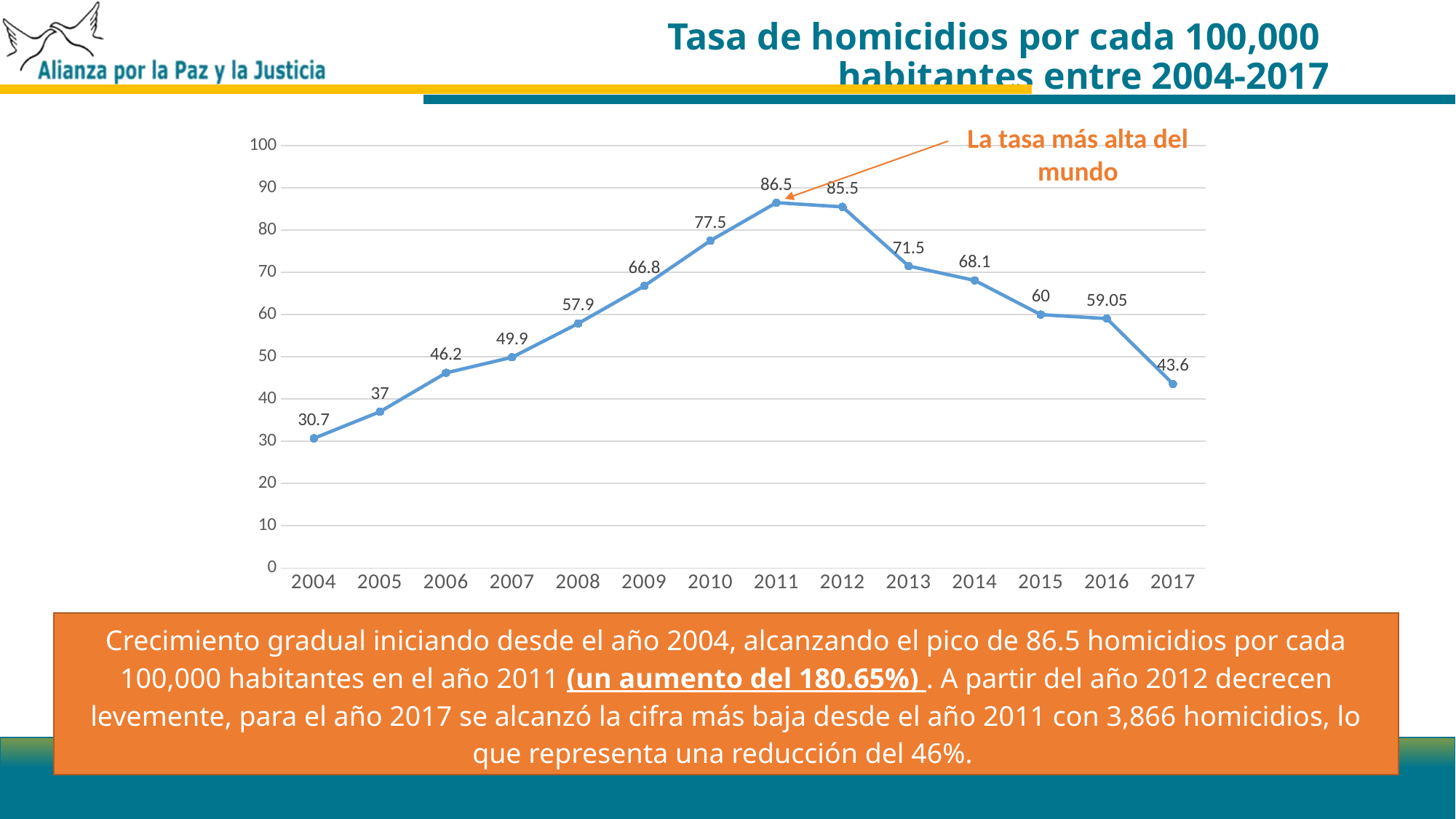
What is the homicide rate shown for 2011? 86.5 Which year has a higher homicide rate, 2010 or 2013? 2010 How many years are plotted on the x axis? 14 What is the difference between the homicide rate in 2011 and in 2017? 42.9 What is the homicide rate shown for 2017? 43.6 What is the homicide rate shown for 2004? 30.7 Which year has the lowest homicide rate? 2004 What is the homicide rate shown for 2016? 59.05 What kind of chart is shown on the slide? Line chart Does the homicide rate rise or fall from 2011 to 2017? Fall Which year has the highest homicide rate? 2011 Is the value for 2009 greater or less than 60? greater